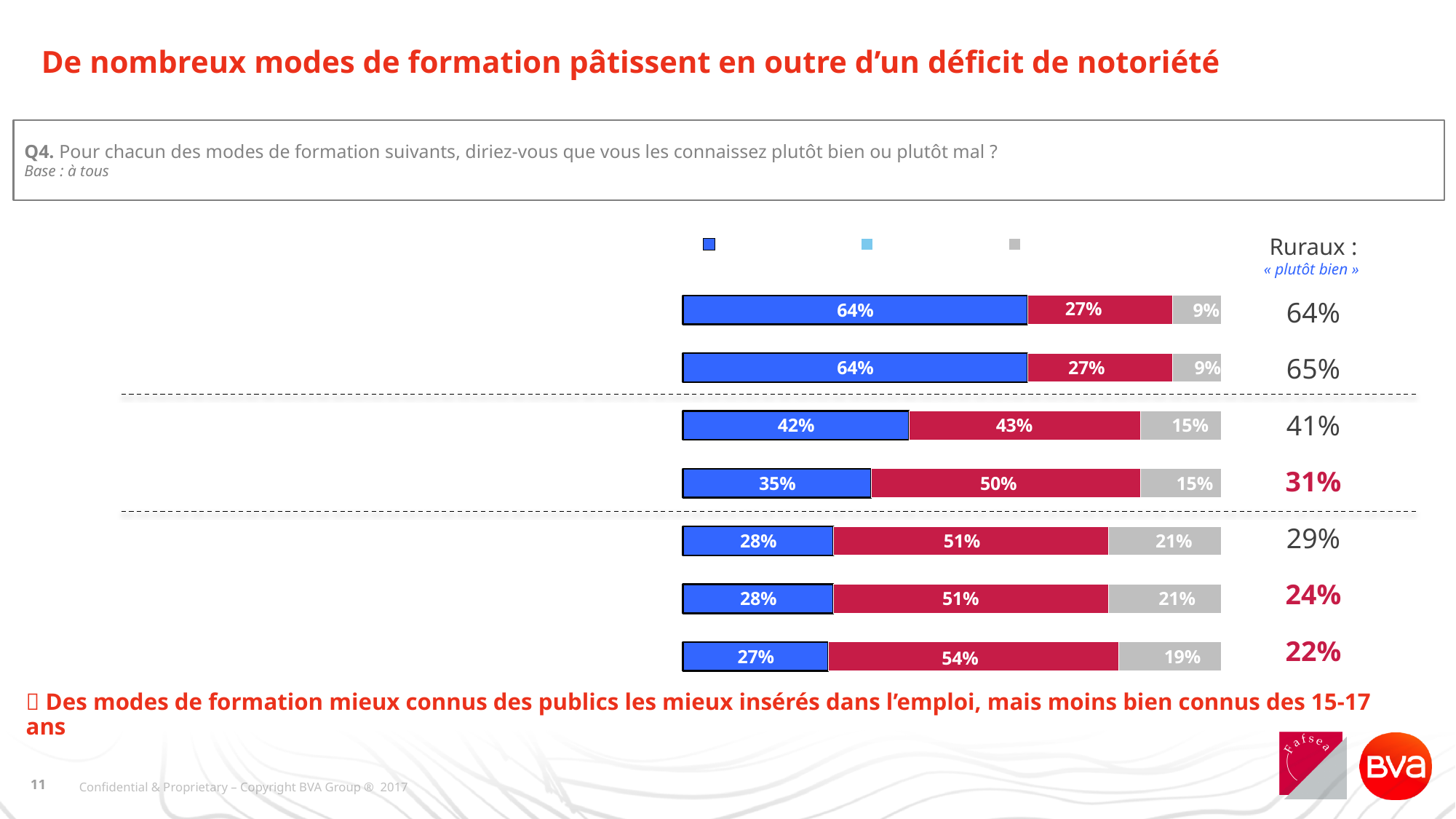
How many coloured segments make up each bar in the chart? 3 What is the total of the three segments in the top bar? 100% What is the difference between the blue segment of the top bar and the blue segment of the bottom bar? 37 percentage points How many bars does the chart contain? 7 What is the value of the red segment in the bottom bar of the chart? 54% What is the value of the grey segment in the fourth bar from the top? 15% In the 'Ruraux : « plutôt bien »' column to the right of the chart, what value is shown for the bottom row? 22% In the fourth bar from the top, which segment is larger, the blue one or the red one? the red one What kind of chart is shown on the slide? stacked bar chart Do the blue segments increase or decrease going from the top bar to the bottom bar? decrease What is the value of the blue segment in the top bar of the chart? 64% Which bar has the largest red segment? the bottom bar (54%)